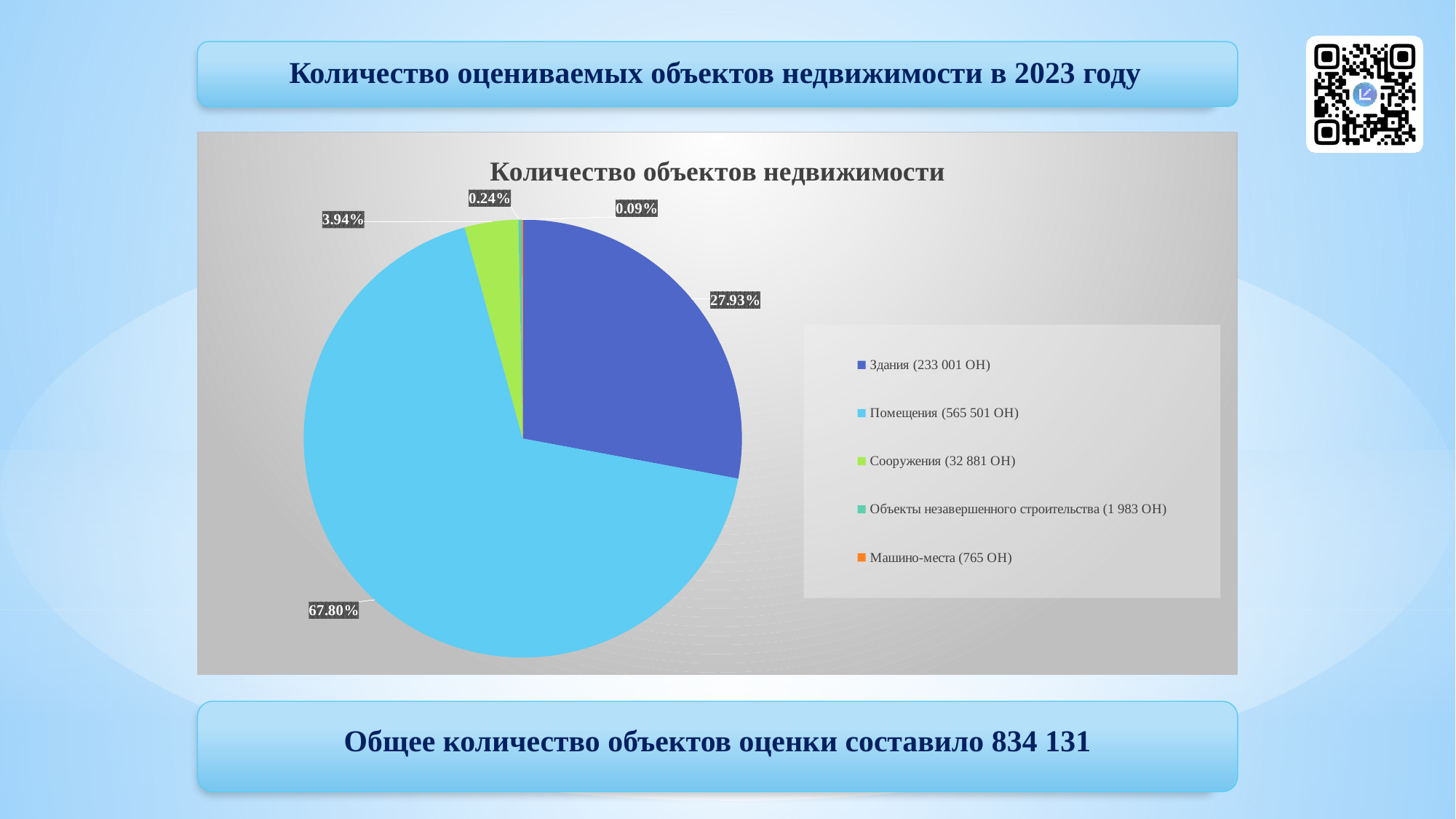
What share of the pie does Сооружения take? 3.94% How many objects (ОН) are listed in the legend for Здания? 233 001 ОН How many slices does the pie chart have? 5 What share of the pie does Машино-места take? 0.09% How many objects (ОН) are listed in the legend for Объекты незавершенного строительства? 1 983 ОН Which category has the largest slice of the pie? Помещения What share of the pie does Здания take? 27.93% Which is larger, the share for Здания or the share for Сооружения? Здания Which category has the smallest slice of the pie? Машино-места What kind of chart is shown on the slide? pie chart What is the title of the chart? Количество объектов недвижимости